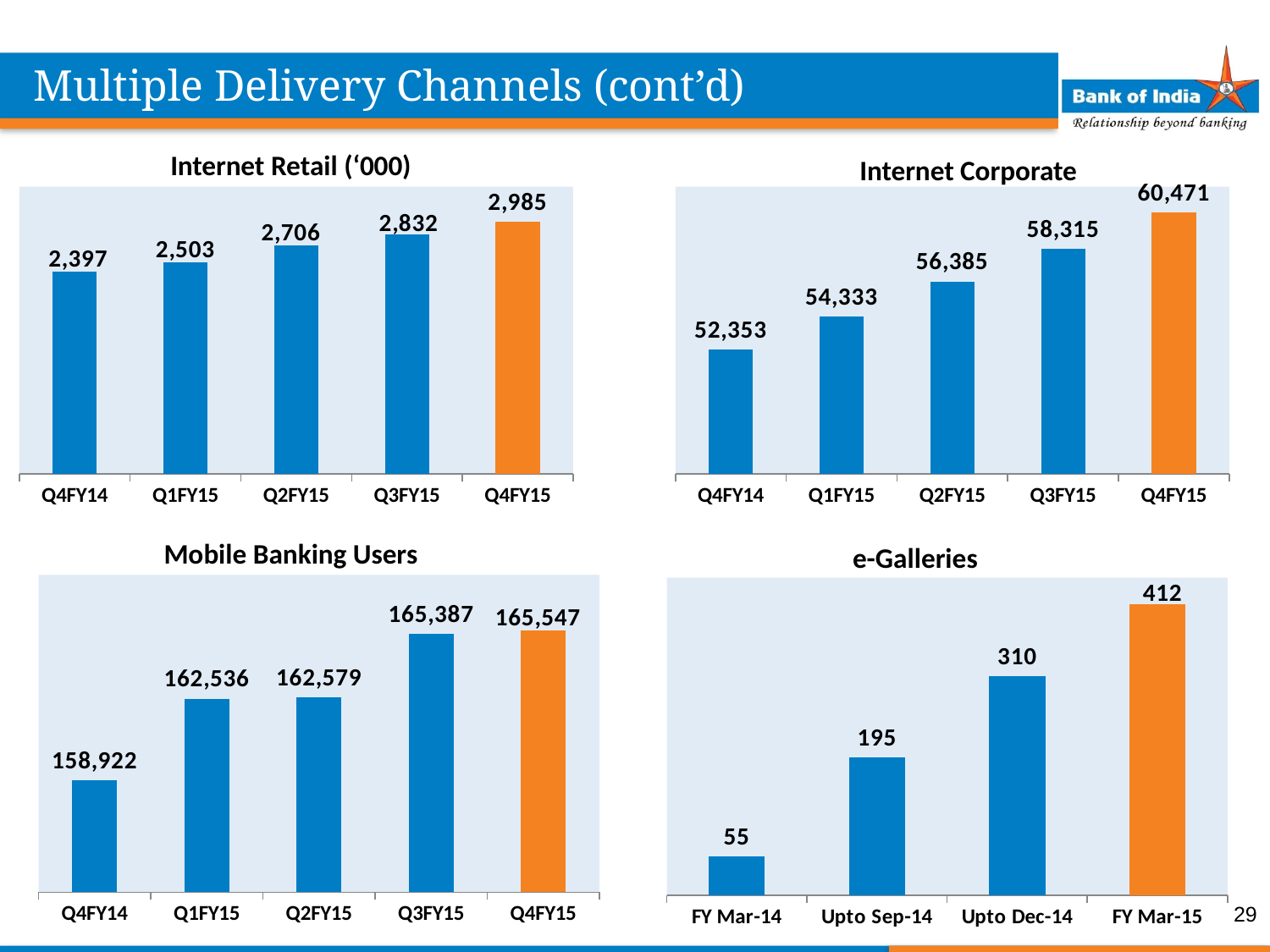
In the Internet Retail ('000) chart, how many quarters are shown? 5 In the Internet Corporate chart, is the value for Q3FY15 larger than the value for Q2FY15? Yes In the Internet Retail ('000) chart, what colour is the Q4FY15 bar? Orange In the Mobile Banking Users chart, which quarter has the lowest value? Q4FY14 In the e-Galleries chart, what is the value for Upto Dec-14? 310 In the Internet Retail ('000) chart, what is the value for Q2FY15? 2,706 What kind of chart is the Mobile Banking Users chart? Bar chart In the Internet Corporate chart, what is the value for Q1FY15? 54,333 In the Internet Corporate chart, which quarter has the highest value? Q4FY15 In the e-Galleries chart, do the values rise or fall from left to right? Rise In the e-Galleries chart, what is the difference between FY Mar-15 and FY Mar-14? 357 In the Mobile Banking Users chart, what is the difference between Q4FY15 and Q4FY14? 6,625